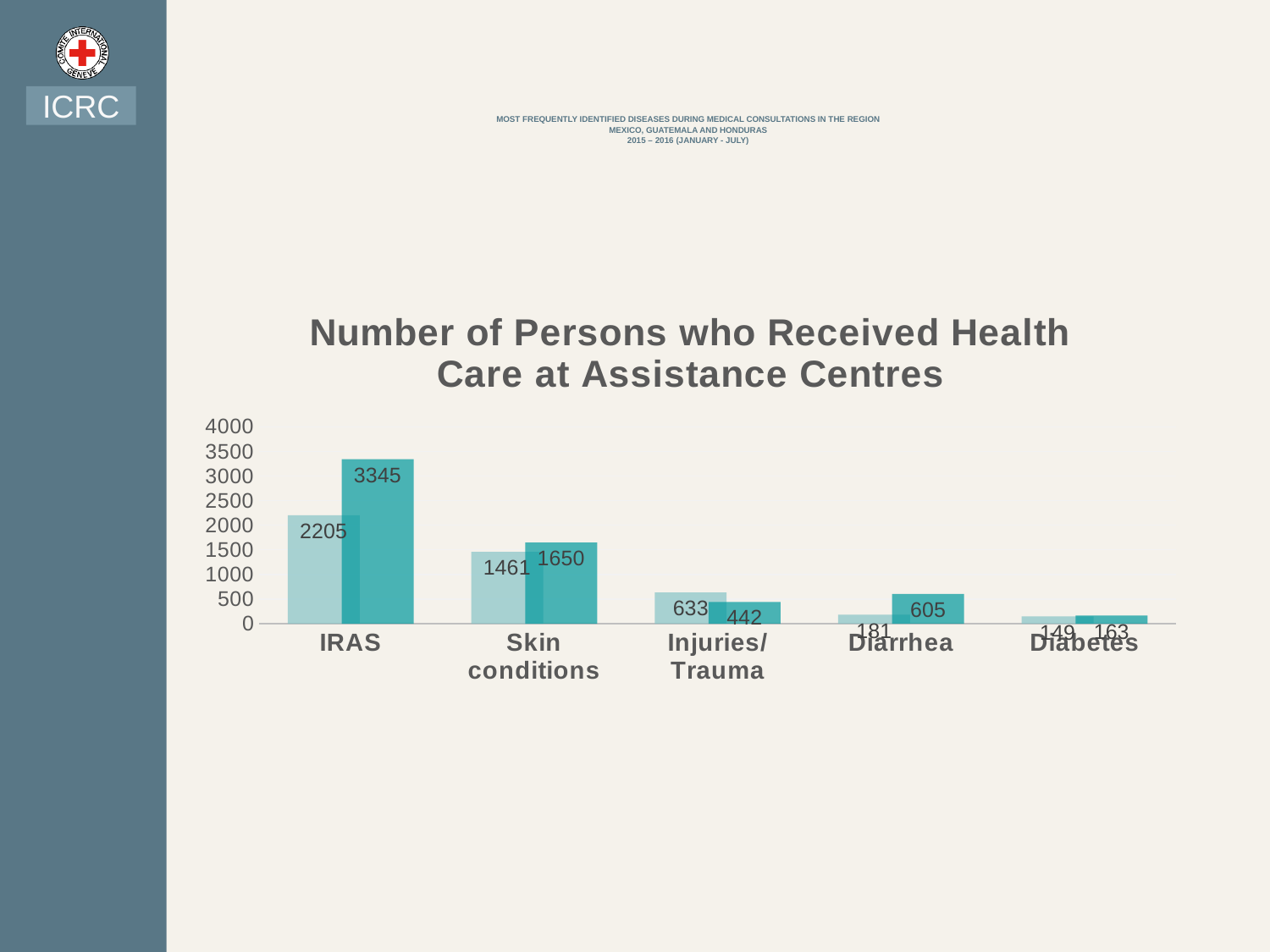
Which is larger for Injuries/Trauma, the lighter (first) bar or the darker (second) bar? the lighter (first) bar What is the value of the darker (second) bar for Diarrhea? 605 What is the value of the darker (second) bar for IRAS? 3345 What kind of chart is shown on the slide? bar chart What is the value of the lighter (first) bar for IRAS? 2205 Which category has the lowest lighter (first) bar in the chart? Diabetes Which category has the highest bar in the chart? IRAS How many categories are shown on the x axis of the chart? 5 What is the value of the lighter (first) bar for Skin conditions? 1461 Is the value of the darker (second) bar for Skin conditions greater or less than 1500? greater What is the difference between the darker and lighter bars for IRAS? 1140 What is the chart's title? Number of Persons who Received Health Care at Assistance Centres